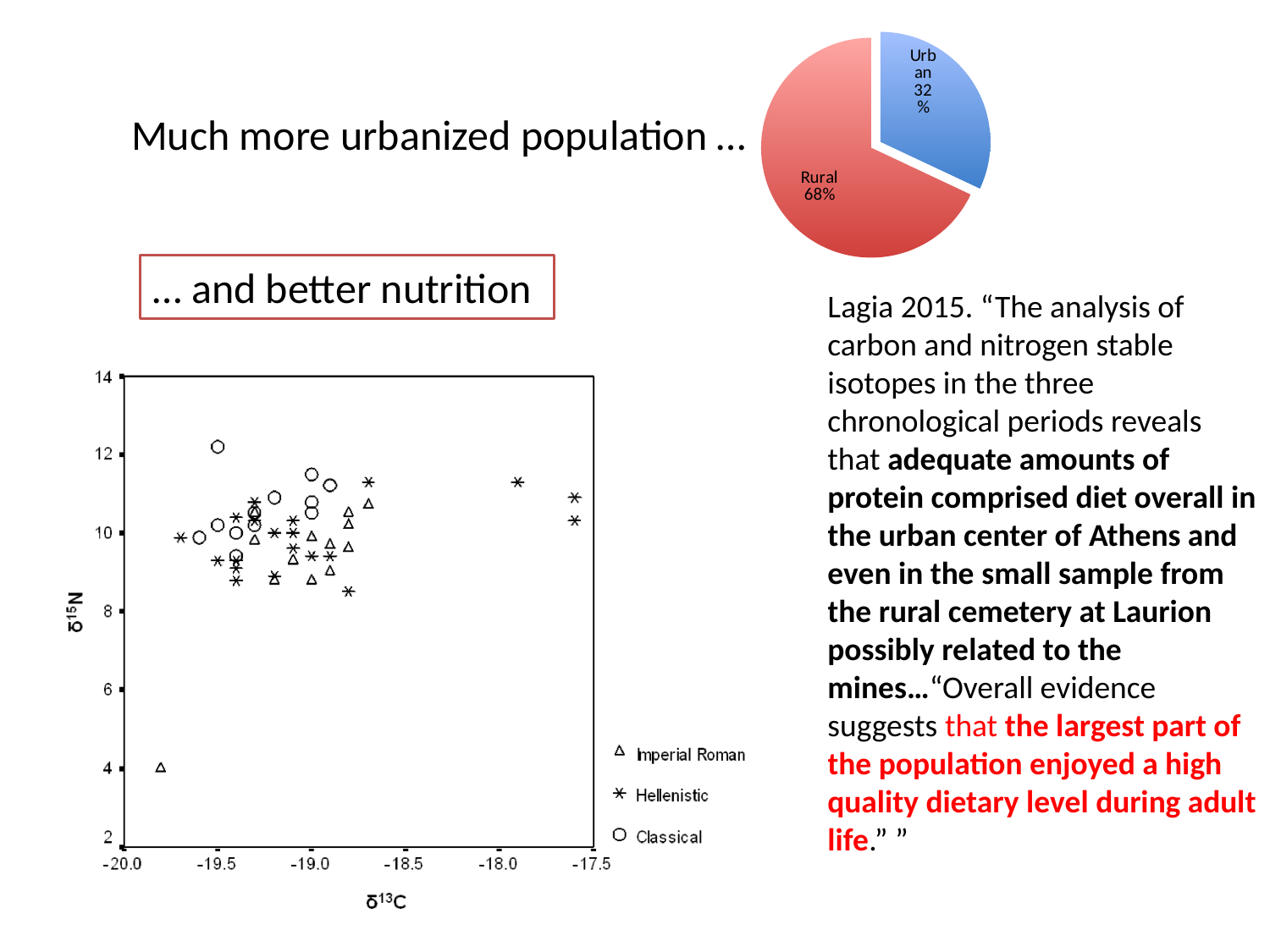
In the scatter plot at the bottom left, how many series does the legend list? 3 What kind of chart is shown at the bottom left of the slide? Scatter plot In the scatter plot at the bottom left, what is the label on the x axis? δ13C In the pie chart at the top right, which slice is the largest? Rural In the scatter plot at the bottom left, which series is represented by circles in the legend? Classical In the pie chart at the top right, how many slices are there? 2 In the pie chart at the top right, what is the difference in percentage points between the Rural and Urban slices? 36 In the scatter plot at the bottom left, is the lowest δ15N value plotted greater or less than 6? less In the pie chart at the top right, which slice is the smallest? Urban In the pie chart at the top right, what percentage is labelled Rural? 68% What kind of chart is shown at the top right of the slide? Pie chart In the pie chart at the top right, what percentage is labelled Urban? 32%